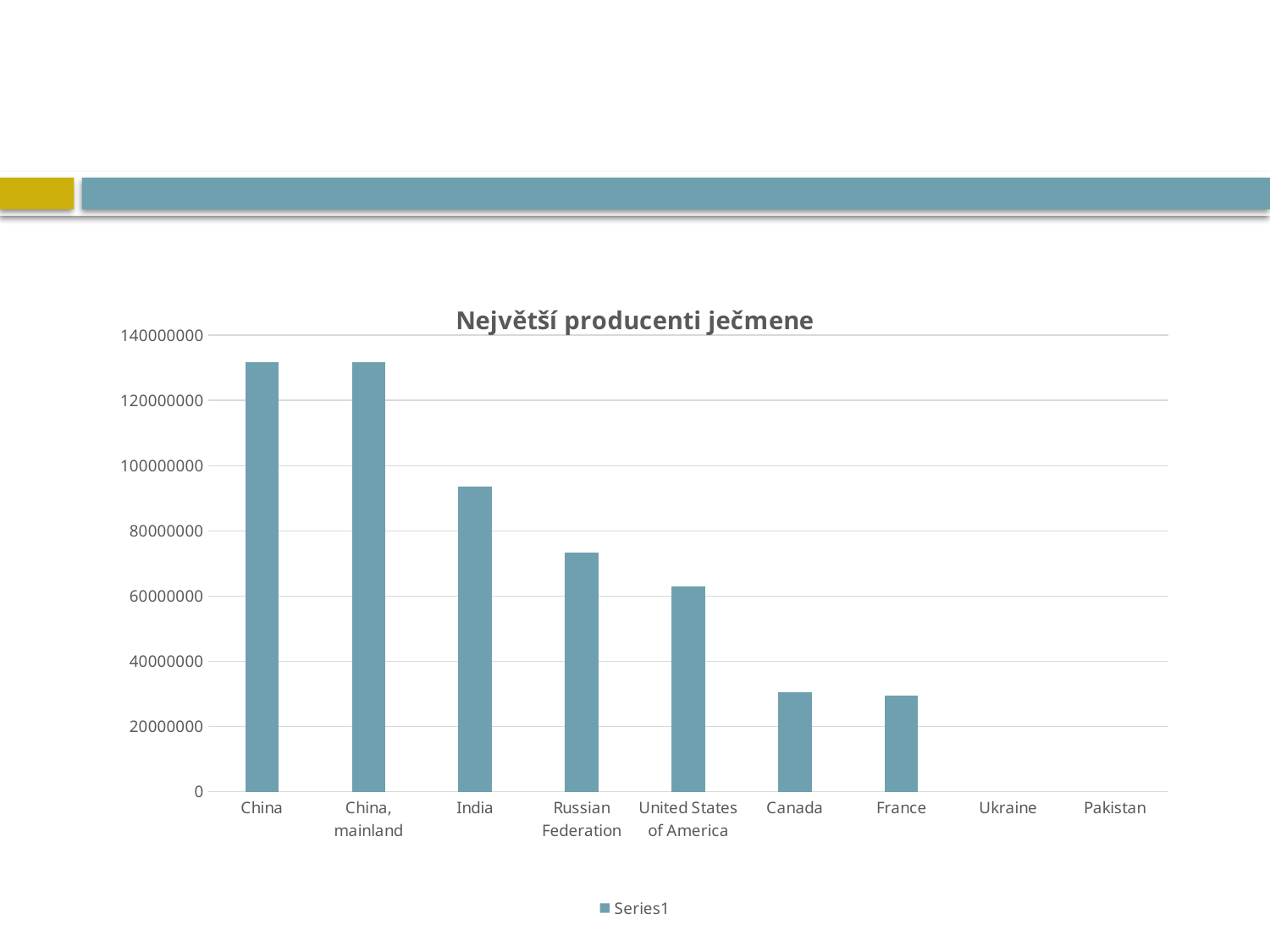
Do the values generally rise or fall moving from left to right along the x axis? fall What kind of chart is shown on the slide? bar chart What is the name of the series shown in the legend? Series1 Is the value for China greater or less than 120000000? greater What is the title of the chart? Největší producenti ječmene Is the value for Russian Federation greater or less than 80000000? less Is the value for India greater or less than 80000000? greater How many series does the legend list? 1 Which has a larger value, India or Russian Federation? India How many categories are shown on the x axis of the chart? 9